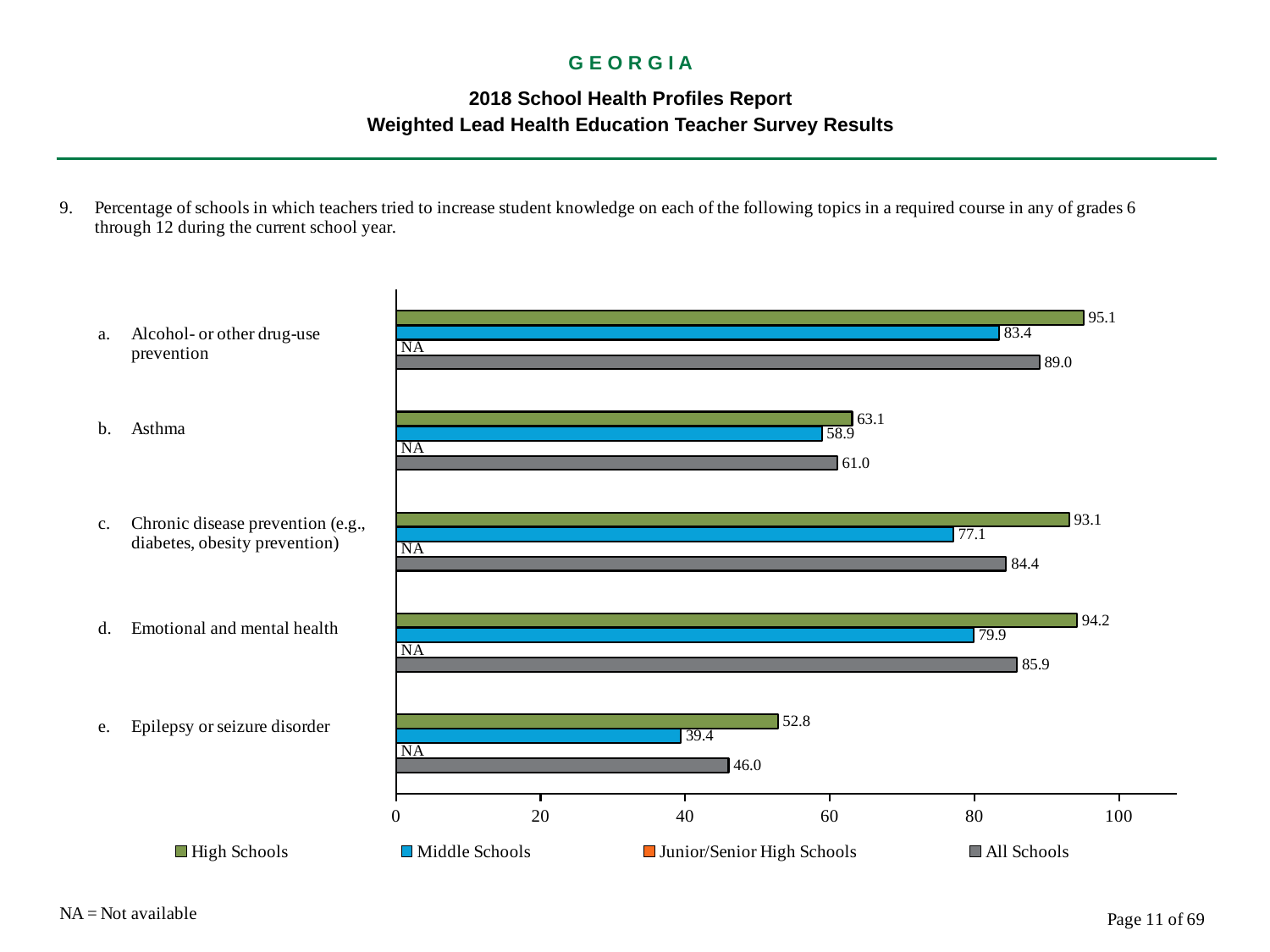
How many series does the legend list? 4 Is the Middle Schools value for Asthma greater or less than 60? less Which is larger for Asthma: the High Schools value or the All Schools value? High Schools What value is shown for Junior/Senior High Schools for each topic? NA What is the All Schools value for Chronic disease prevention (e.g., diabetes, obesity prevention)? 84.4 Which topic has the lowest All Schools value? Epilepsy or seizure disorder How many topics are listed on the chart? 5 Which topic has the highest High Schools value? Alcohol- or other drug-use prevention What kind of chart is shown on the slide? bar chart What is the Middle Schools value for Epilepsy or seizure disorder? 39.4 What is the High Schools value for Alcohol- or other drug-use prevention? 95.1 What is the difference between the High Schools and Middle Schools values for Emotional and mental health? 14.3